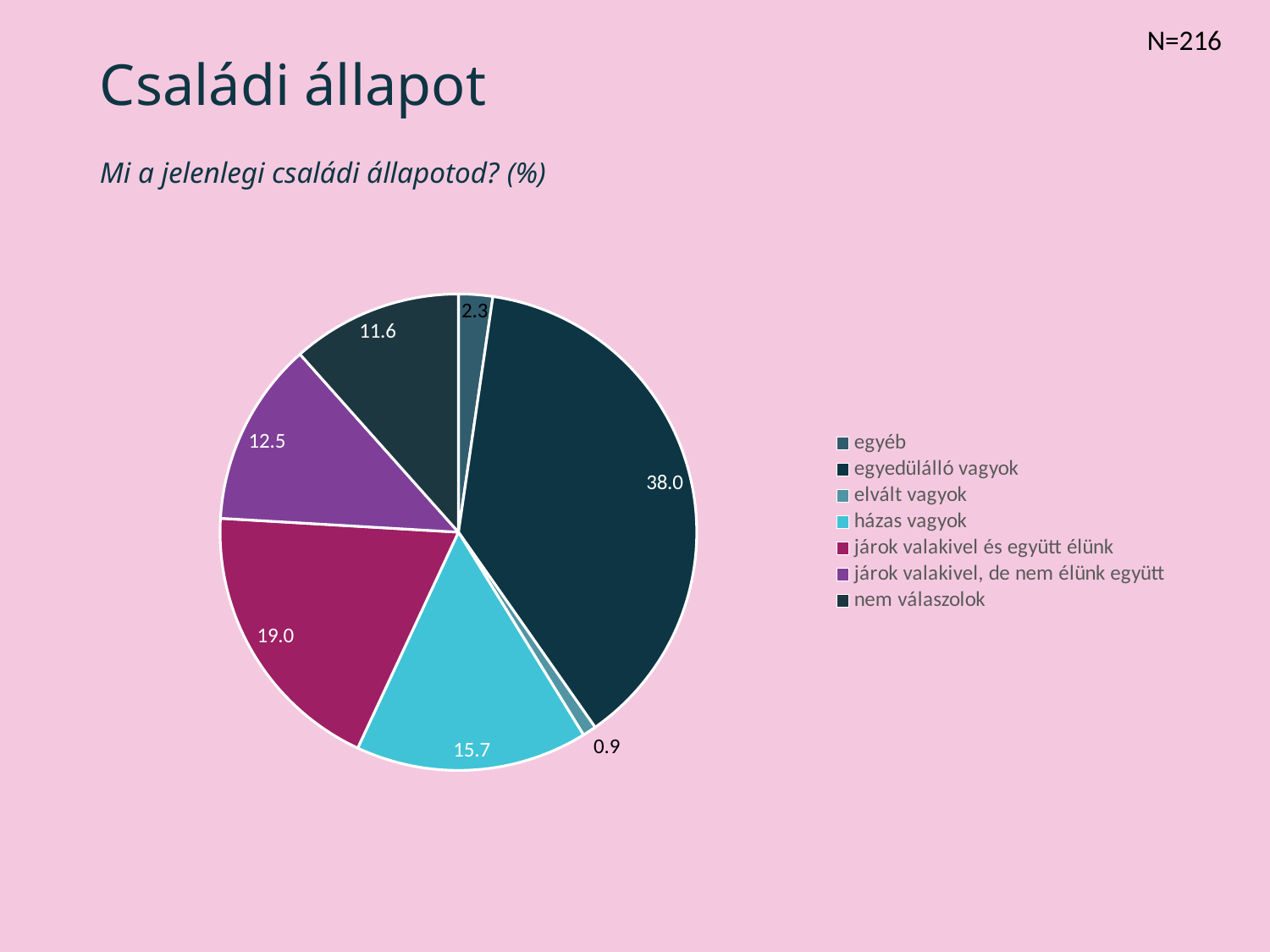
What is the value for "házas vagyok"? 15.7 What is the value for "nem válaszolok"? 11.6 What is the difference between the values for "egyedülálló vagyok" and "járok valakivel és együtt élünk"? 19.0 What is the value for "egyedülálló vagyok"? 38.0 Which category has the smallest slice of the pie? elvált vagyok How many categories does the legend list? 7 Which is larger, the value for "járok valakivel, de nem élünk együtt" or the value for "nem válaszolok"? járok valakivel, de nem élünk együtt What is the value for "elvált vagyok"? 0.9 Which category has the largest slice of the pie? egyedülálló vagyok What kind of chart is shown on the slide? pie chart What is the title of the slide containing the chart? Családi állapot What is the value for "járok valakivel és együtt élünk"? 19.0